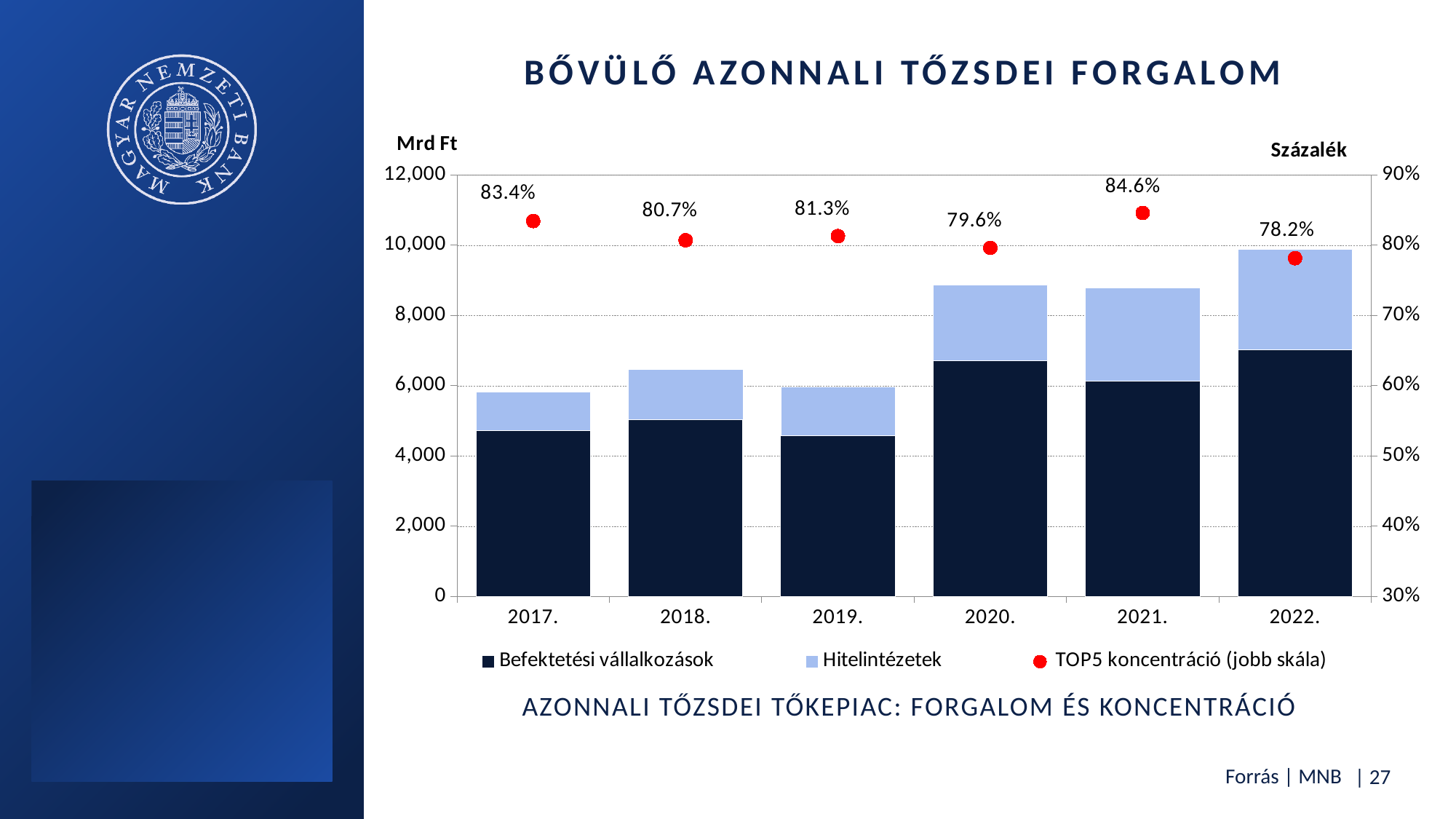
In which year is the TOP5 koncentráció highest? 2021. Is the Befektetési vállalkozások value for 2017 greater or less than 4,000? greater How many series does the chart legend list? 3 What is the TOP5 koncentráció value for 2017? 83.4% What is the difference between the TOP5 koncentráció values for 2021 and 2022? 6.4 percentage points Which year has the larger TOP5 koncentráció value, 2018 or 2019? 2019. How many years are shown on the x axis of the chart? 6 Is the total stacked bar value for 2020 greater or less than 8,000? greater What is the TOP5 koncentráció value for 2020? 79.6% What kind of chart is used for the Befektetési vállalkozások and Hitelintézetek series? Stacked bar chart In which year is the TOP5 koncentráció lowest? 2022. What unit is shown on the left axis of the chart? Mrd Ft